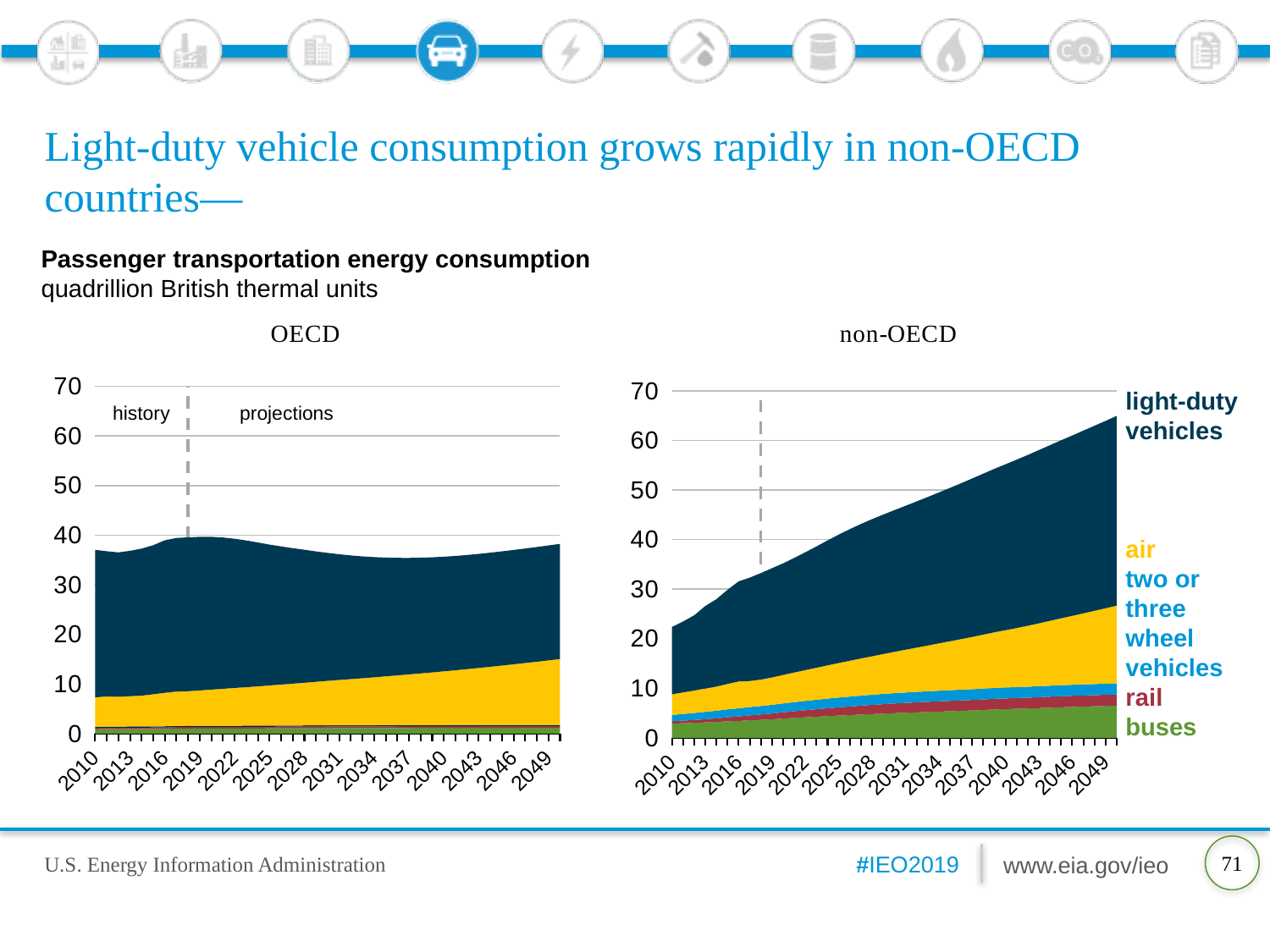
On the non-OECD chart, does total passenger transportation energy consumption rise or fall from 2010 to 2049? rise How many year labels are shown on the x axis of the non-OECD chart? 14 On the non-OECD chart, is the total consumption in 2010 greater or less than 20? greater Which chart shows the larger total passenger transportation energy consumption in 2049, OECD or non-OECD? non-OECD What kind of chart is the OECD chart? stacked area chart How many series does the legend on the non-OECD chart list? 5 In what units is passenger transportation energy consumption measured on these charts? quadrillion British thermal units Which chart shows the larger total passenger transportation energy consumption in 2010, OECD or non-OECD? OECD What does the vertical dashed line on the OECD chart separate? history and projections On the OECD chart, is the total passenger transportation energy consumption in 2049 greater or less than 40? less On the non-OECD chart, is the total passenger transportation energy consumption in 2049 greater or less than 60? greater